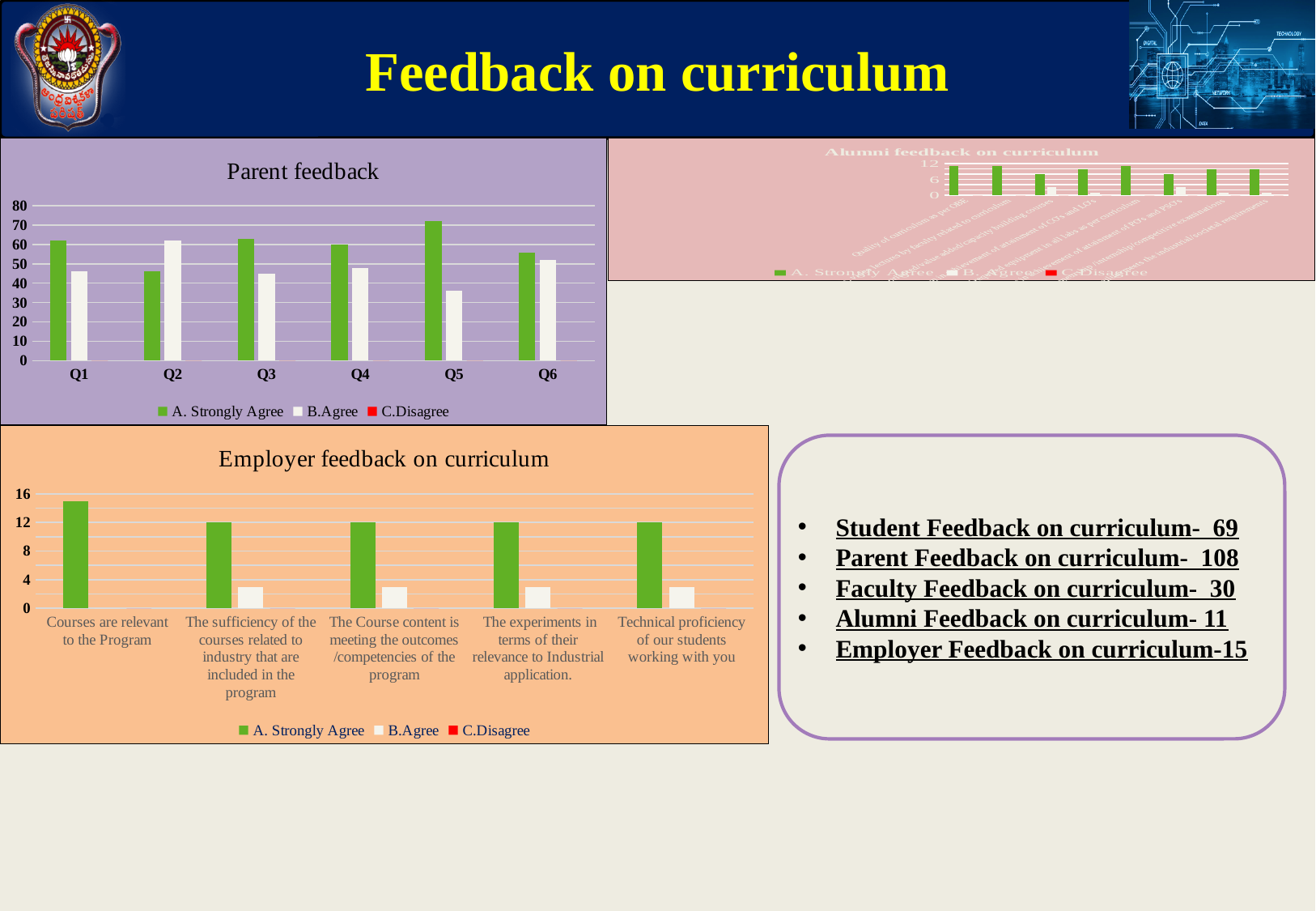
In the Parent feedback chart, which question has the highest A. Strongly Agree value? Q5 What kind of chart is the Parent feedback chart? bar chart In the Parent feedback chart, is the A. Strongly Agree value for Q5 greater or less than 60? greater In the Parent feedback chart, which question has the lowest A. Strongly Agree value? Q2 In the Employer feedback on curriculum chart, is the B.Agree value for 'The sufficiency of the courses related to industry that are included in the program' greater or less than 4? less In the Employer feedback on curriculum chart, what is the A. Strongly Agree value for 'Technical proficiency of our students working with you'? 12 In the Employer feedback on curriculum chart, which category has the highest A. Strongly Agree value? Courses are relevant to the Program How many questions (categories) are shown on the x axis of the Parent feedback chart? 6 In the Parent feedback chart, is the B.Agree value for Q5 greater or less than 40? less How many series does the legend of the Parent feedback chart list? 3 How many categories are shown on the x axis of the Employer feedback on curriculum chart? 5 In the Parent feedback chart, for Q2, which is larger: A. Strongly Agree or B.Agree? B.Agree